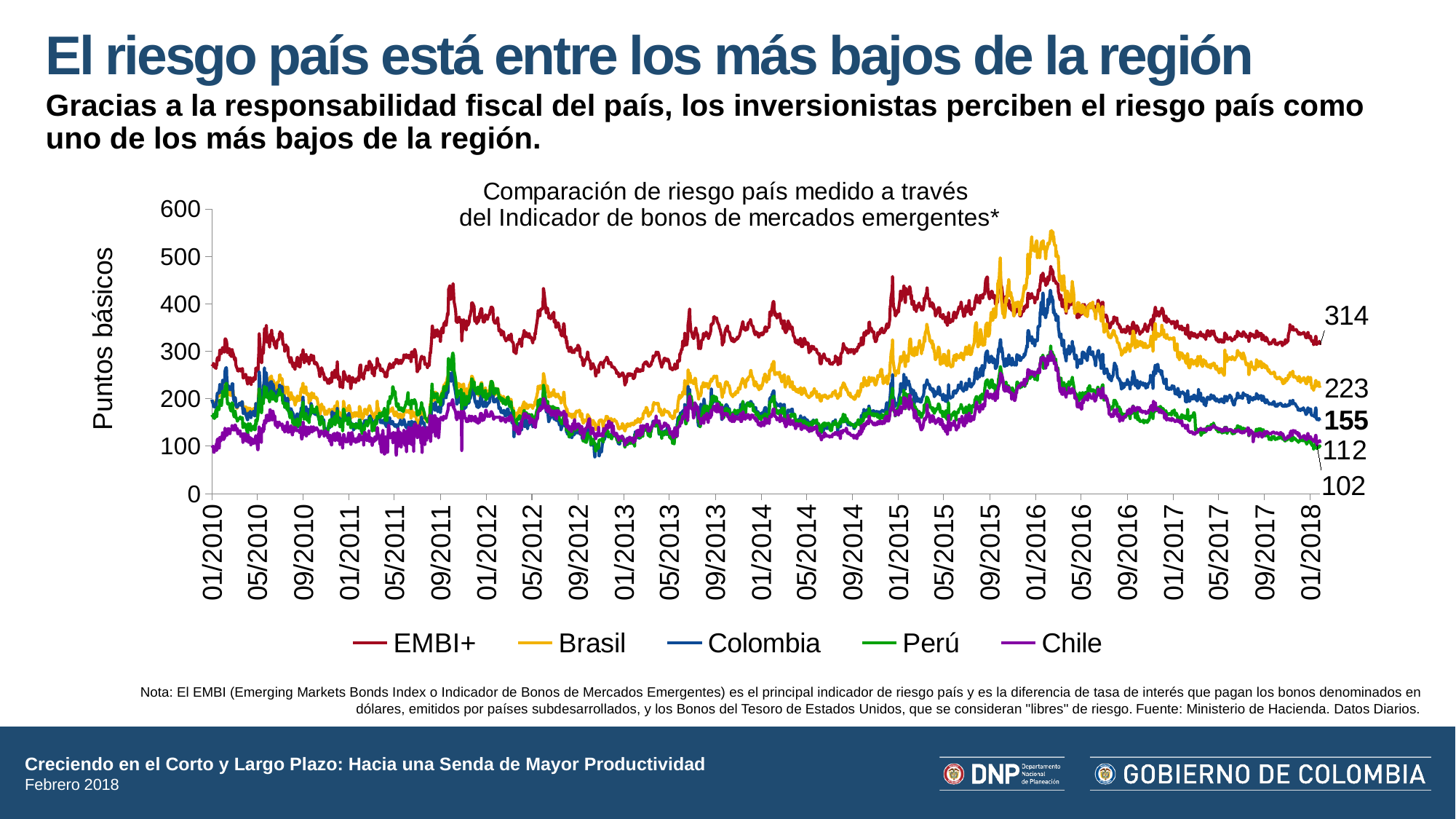
What is the final value labelled for Chile at the right end of the chart? 102 What is the final value labelled for the EMBI+ series at the right end of the chart? 314 What is the final value labelled for Brasil at the right end of the chart? 223 Which series has the highest value at the right end of the chart (01/2018)? EMBI+ What is the label on the vertical axis of the chart? Puntos básicos Is the value for Chile at 01/2010 greater or less than 200? less What kind of chart is shown on the slide? line chart What is the difference between the final labelled values of EMBI+ and Colombia? 159 How many series does the legend list? 5 Is the peak value of the Brasil series around 01/2016 greater or less than 500? greater Which series has the lowest value at the right end of the chart (01/2018)? Chile What is the final value labelled for Colombia at the right end of the chart? 155